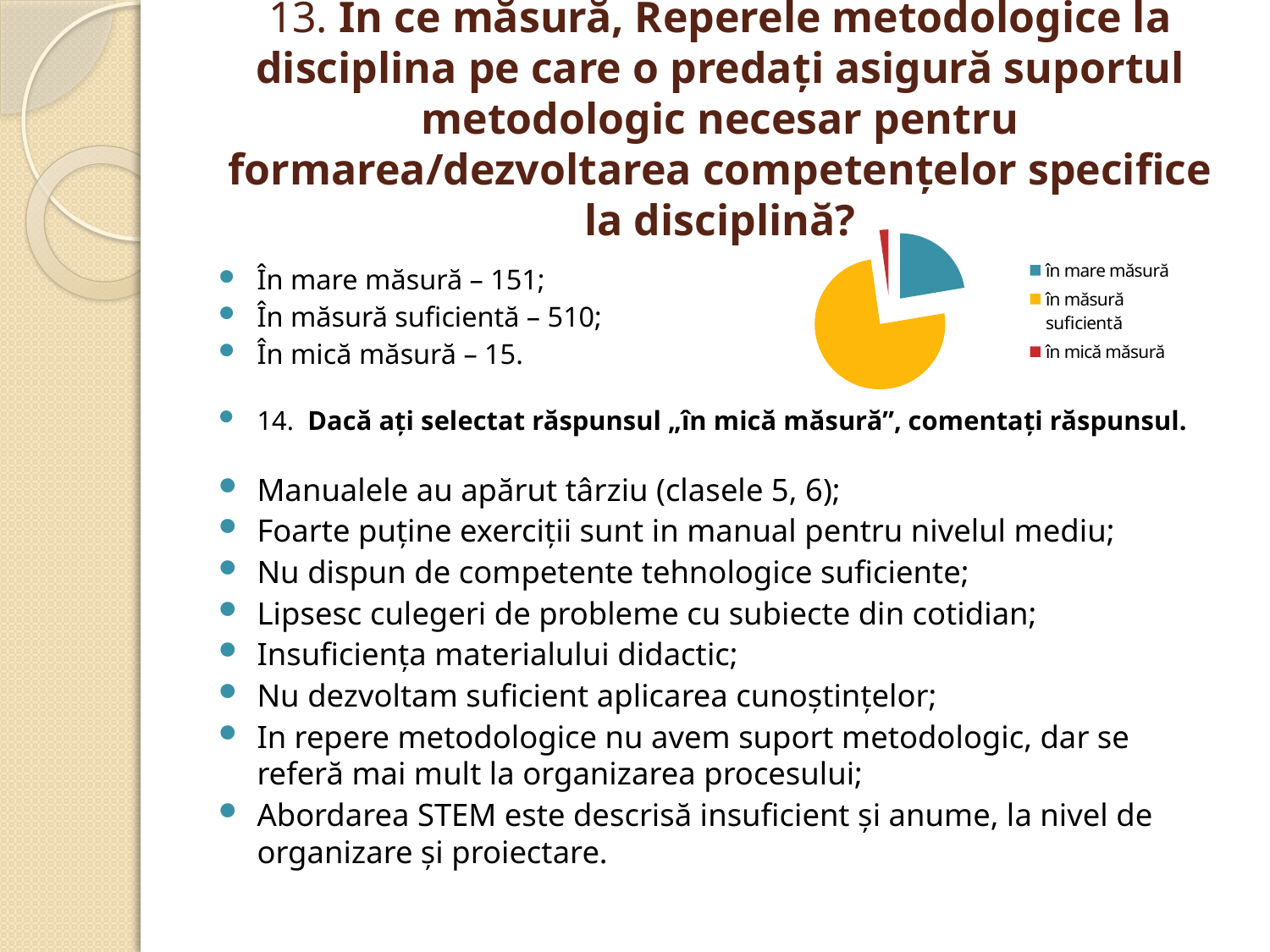
Which slice is larger in the pie chart: în mare măsură or în mică măsură? în mare măsură How many entries does the legend of the pie chart list? 3 Which category has the smallest slice in the pie chart? în mică măsură What is the total of all three values shown in the pie chart? 676 What colour is the slice for în măsură suficientă in the pie chart? yellow Which category has the largest slice in the pie chart? în măsură suficientă What kind of chart is shown on the slide? pie chart What is the value for în mică măsură? 15 What is the difference between the values for în măsură suficientă and în mare măsură? 359 What is the value for în măsură suficientă? 510 What is the value for în mare măsură? 151 How many slices does the pie chart have? 3